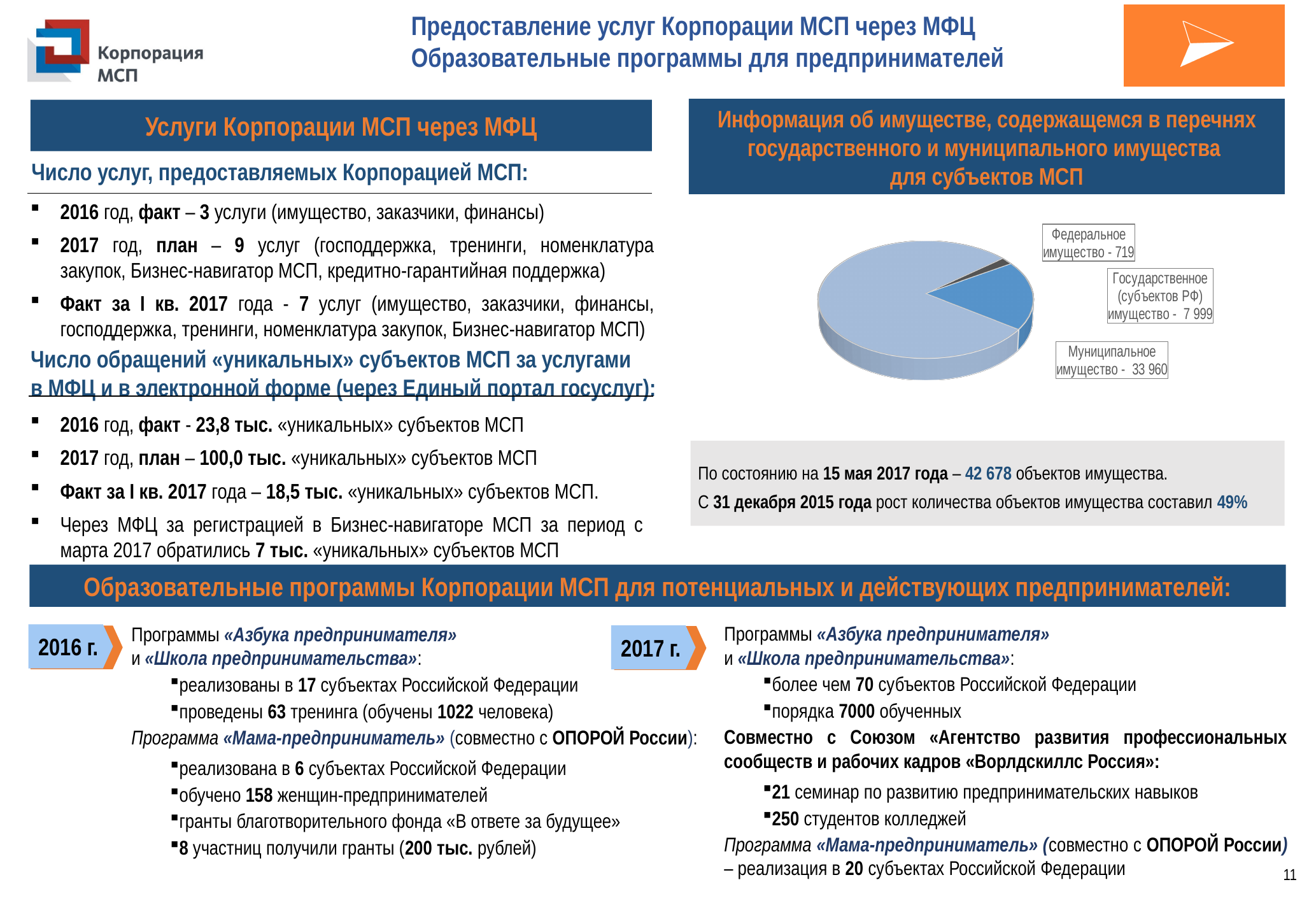
Which is larger in the pie chart: Государственное (субъектов РФ) имущество or Федеральное имущество? Государственное (субъектов РФ) имущество How many slices does the pie chart have? 3 What is the difference between Муниципальное имущество and Государственное (субъектов РФ) имущество in the pie chart? 25 961 What type of chart is shown on the slide? Pie chart Which category has the largest slice in the pie chart? Муниципальное имущество What is the value for Государственное (субъектов РФ) имущество in the pie chart? 7 999 What is the difference between Государственное (субъектов РФ) имущество and Федеральное имущество in the pie chart? 7 280 What is the value for Федеральное имущество in the pie chart? 719 Which category has the smallest slice in the pie chart? Федеральное имущество What is the value for Муниципальное имущество in the pie chart? 33 960 What is the title of the section containing the pie chart? Информация об имуществе, содержащемся в перечнях государственного и муниципального имущества для субъектов МСП What is the total number of property objects across all three slices of the pie chart? 42 678